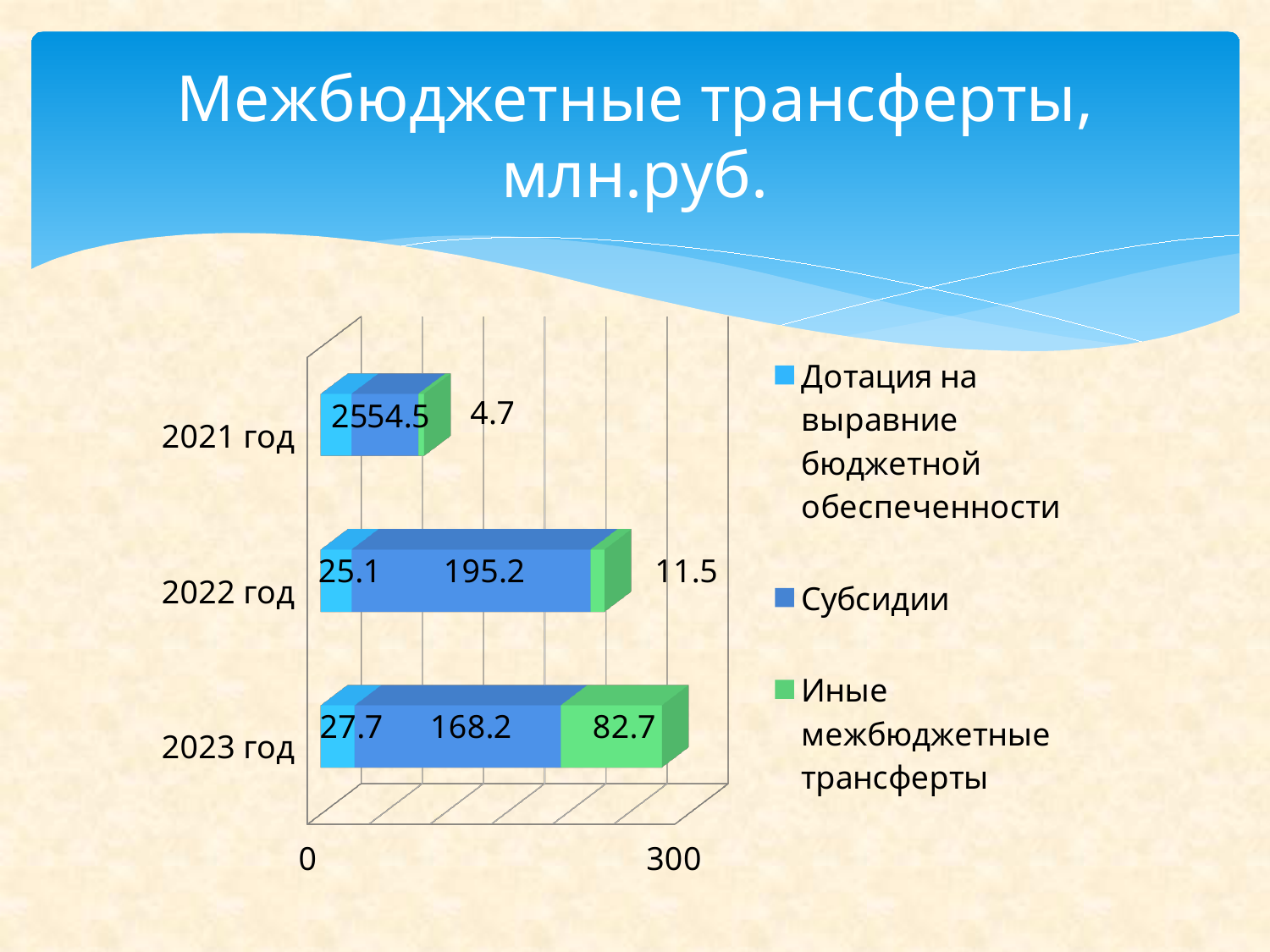
What kind of chart is shown on the slide? bar chart What is the title of the chart on the slide? Межбюджетные трансферты, млн.руб. How many series does the legend list? 3 What is the total of the stacked bar for 2023 год? 278.6 What is the value of Иные межбюджетные трансферты for 2023 год? 82.7 What is the value of Иные межбюджетные трансферты for 2021 год? 4.7 What is the value of Иные межбюджетные трансферты for 2022 год? 11.5 How many years (categories) are plotted on the chart? 3 What is the difference between the Субсидии values for 2022 год and 2023 год? 27 What is the value of Дотация на выравние бюджетной обеспеченности for 2023 год? 27.7 What is the value of Субсидии for 2022 год? 195.2 Which year has the larger value for Иные межбюджетные трансферты, 2022 год or 2023 год? 2023 год